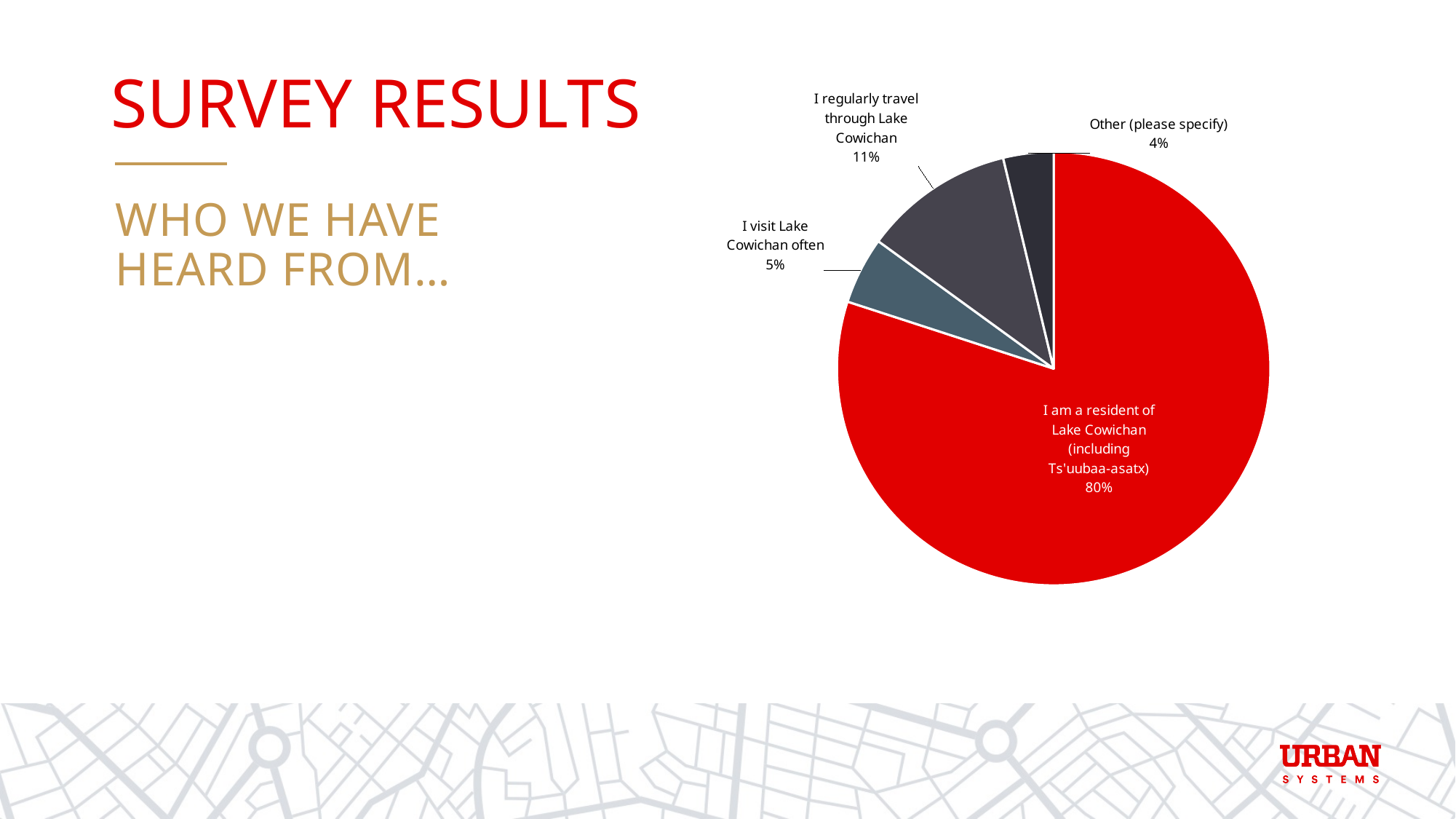
What colour is the largest slice of the pie chart? red Which category has the smallest slice of the pie? Other (please specify) What percentage of respondents chose 'Other (please specify)'? 4% What is the combined share of respondents who visit Lake Cowichan often and those who chose 'Other (please specify)'? 9% How many slices does the pie chart have? 4 What kind of chart is shown on the slide? pie chart What percentage of respondents regularly travel through Lake Cowichan? 11% What share of respondents are residents of Lake Cowichan (including Ts'uubaa-asatx)? 80% What percentage of respondents visit Lake Cowichan often? 5% What is the difference in percentage points between residents of Lake Cowichan and those who regularly travel through Lake Cowichan? 69 Which category has the largest slice of the pie? I am a resident of Lake Cowichan (including Ts'uubaa-asatx) Which is larger: the share who regularly travel through Lake Cowichan or the share who visit Lake Cowichan often? I regularly travel through Lake Cowichan